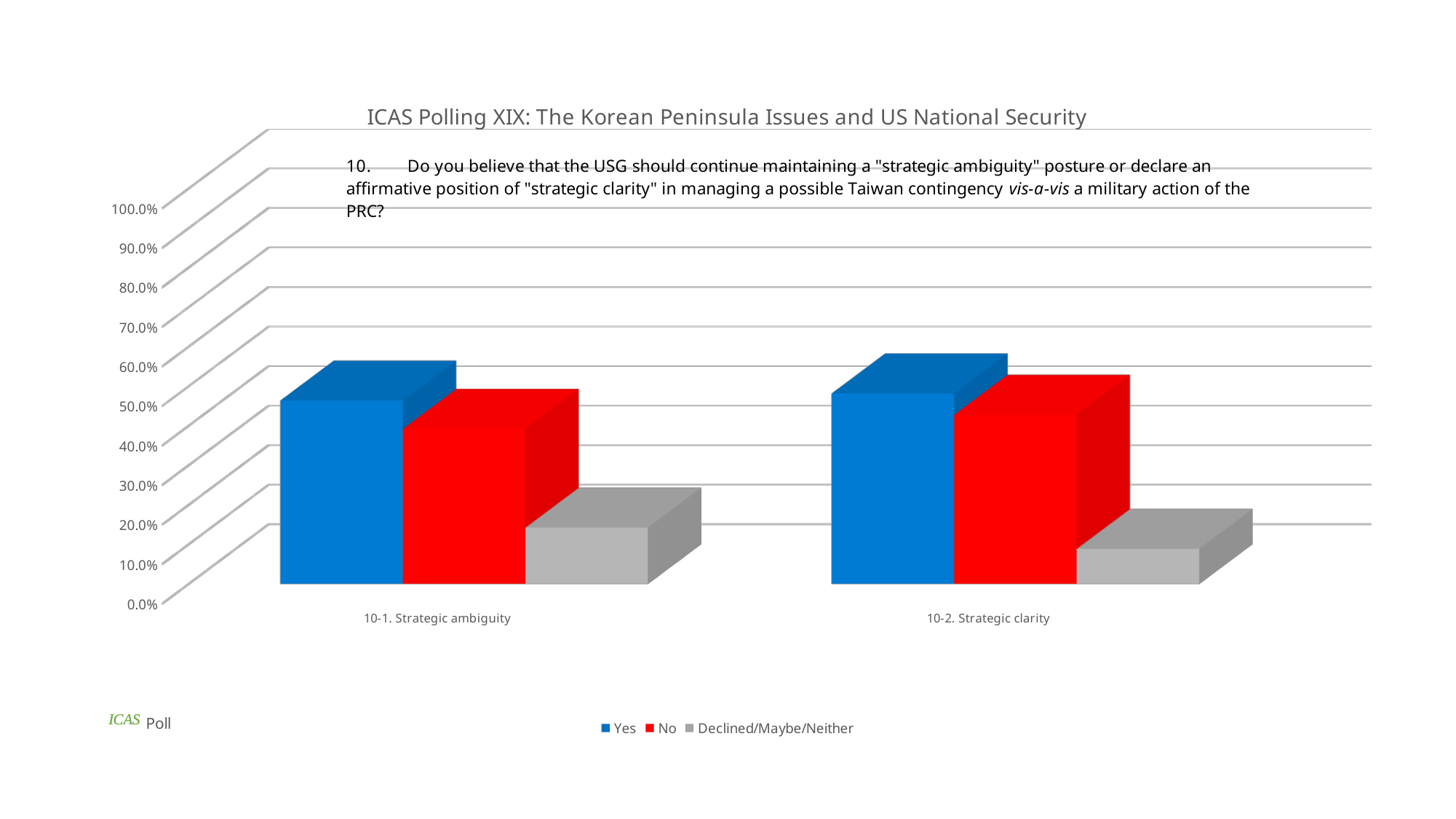
Which colour represents the No series in the chart? red What kind of chart is shown on the slide? bar chart For 10-1. Strategic ambiguity, is the value for Yes larger or the value for No? Yes Which series has the highest value for 10-1. Strategic ambiguity? Yes How many categories are shown on the x axis? 2 Is the value for Yes in 10-1. Strategic ambiguity greater or less than 40.0%? greater Is the value for Declined/Maybe/Neither in 10-2. Strategic clarity greater or less than 20.0%? less How many series does the legend list? 3 Which series has the lowest value for 10-2. Strategic clarity? Declined/Maybe/Neither For 10-2. Strategic clarity, is the value for No larger or the value for Declined/Maybe/Neither? No Is the value for No in 10-1. Strategic ambiguity greater or less than 50.0%? less